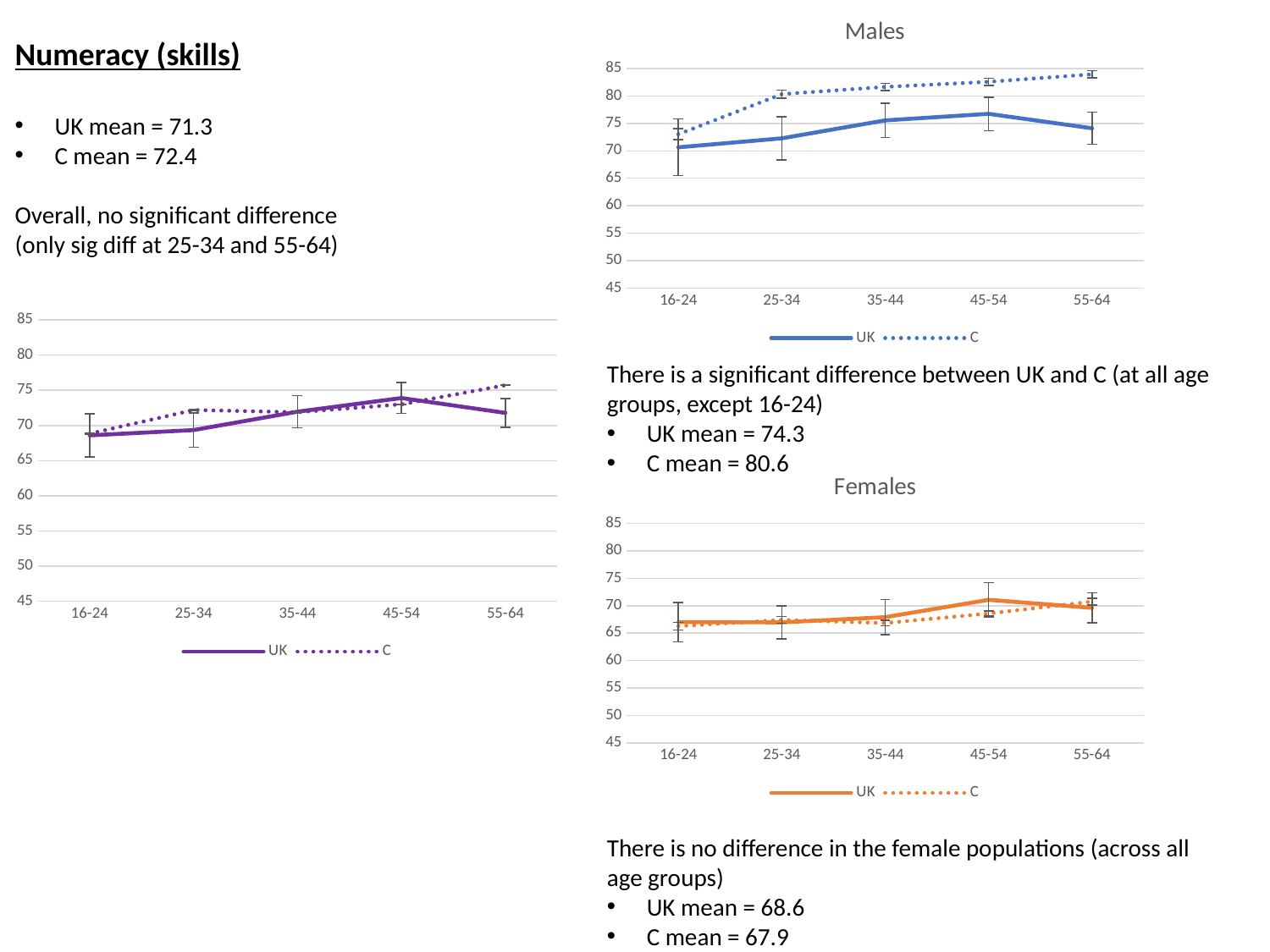
In the Females chart, which age group has the highest value for the UK series? 45-54 In the Males chart, which age group has the highest value for the C series? 55-64 What kind of chart is the chart titled Males? line chart How many age-group categories are shown on the x axis of the Females chart? 5 What are the two legend entries in the Females chart? UK and C In the Males chart, does the C series rise or fall from 16-24 to 55-64? rise In the Males chart, at 55-64, which series has the larger value, UK or C? C In the Males chart, which age group has the lowest value for the C series? 16-24 In the chart on the left of the slide, which age group has the highest value for the C series? 55-64 In the Males chart, is the value for C at 55-64 greater or less than 80? greater How many series does the legend of the Males chart list? 2 In the Females chart, is the value for C at 16-24 greater or less than 70? less